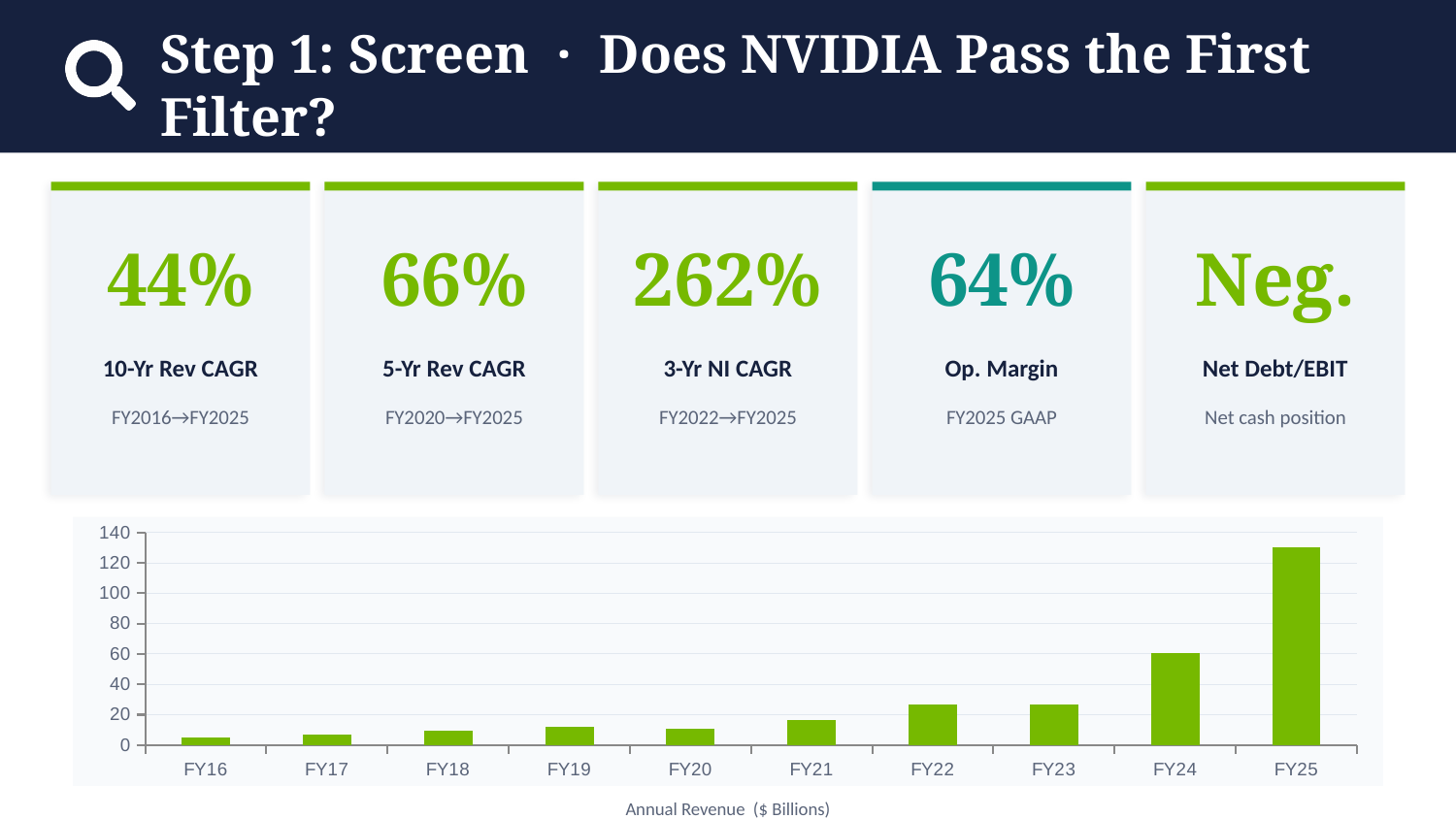
Is the value for FY25 greater or less than 120? greater Is the value for FY24 greater or less than 80? less Which fiscal year has the lowest bar on the Annual Revenue chart? FY16 Is the value for FY22 greater or less than 20? greater What kind of chart is shown at the bottom of the slide? bar chart Do the values on the Annual Revenue chart generally rise or fall from FY16 to FY25? rise Which is larger on the Annual Revenue chart, FY24 or FY22? FY24 How many fiscal years are plotted on the Annual Revenue chart? 10 What unit is the Annual Revenue chart measured in, according to its caption? $ Billions Which fiscal year has the highest bar on the Annual Revenue chart? FY25 Which is larger on the Annual Revenue chart, FY21 or FY17? FY21